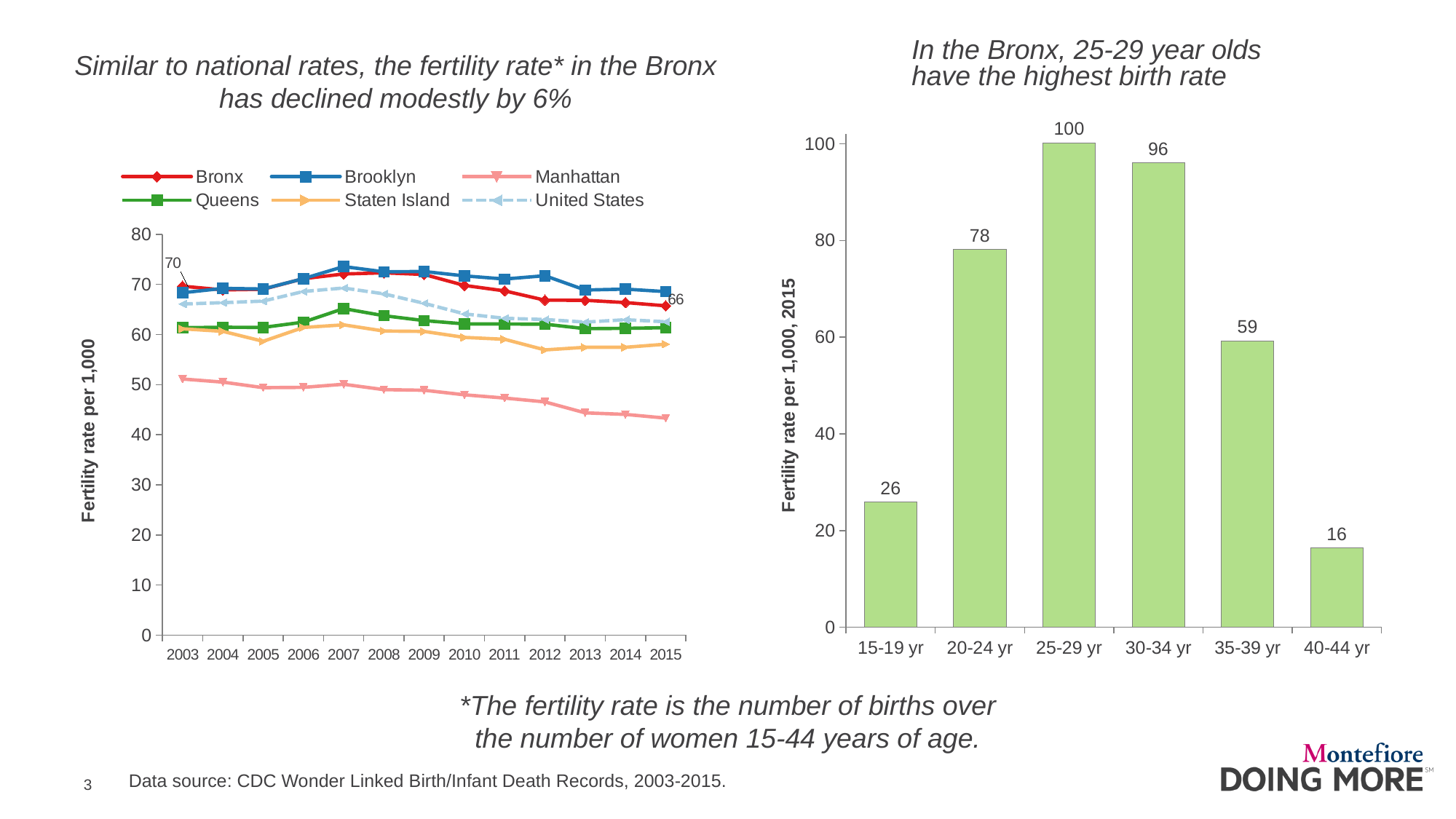
In the bar chart on the right, which has a higher fertility rate: 15-19 yr or 40-44 yr? 15-19 yr In the bar chart on the right, what is the difference between the fertility rates of the 20-24 yr and 35-39 yr age groups? 19 In the line chart on the left, what was the Bronx fertility rate in 2015? 66 In the bar chart on the right, what is the fertility rate for the 40-44 yr age group? 16 In the bar chart on the right, what is the fertility rate for the 25-29 yr age group? 100 In the line chart on the left, what was the Bronx fertility rate in 2003? 70 In the bar chart on the right, which age group has the highest fertility rate? 25-29 yr In the line chart on the left, which borough has the lowest fertility rate across all years shown? Manhattan How many age groups are shown in the bar chart on the right? 6 In the line chart on the left, is the Manhattan fertility rate in 2015 greater or less than 50? less How many series does the legend of the line chart on the left list? 6 In the bar chart on the right, which age group has the lowest fertility rate? 40-44 yr